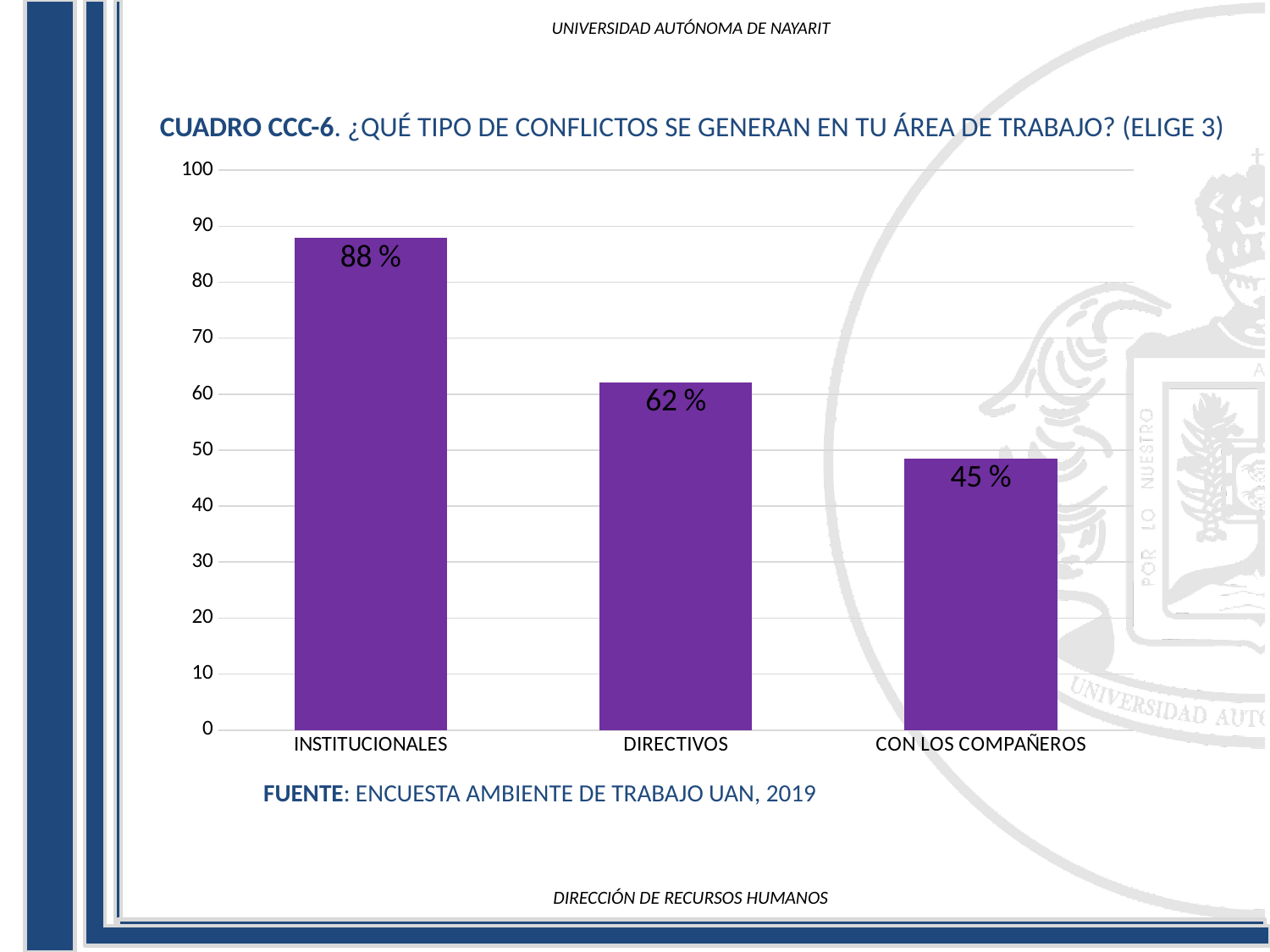
What is the value for DIRECTIVOS? 62 % What is the value for CON LOS COMPAÑEROS? 45 % Which is larger, the value for DIRECTIVOS or the value for CON LOS COMPAÑEROS? DIRECTIVOS How many categories are shown on the chart? 3 What is the difference between the values for DIRECTIVOS and CON LOS COMPAÑEROS? 17 % What is the difference between the values for INSTITUCIONALES and DIRECTIVOS? 26 % What source is cited below the chart? ENCUESTA AMBIENTE DE TRABAJO UAN, 2019 What is the value for INSTITUCIONALES? 88 % Which category has the lowest value? CON LOS COMPAÑEROS Is the value for CON LOS COMPAÑEROS greater or less than 50? less What kind of chart is shown on the slide? bar chart Which category has the highest value? INSTITUCIONALES